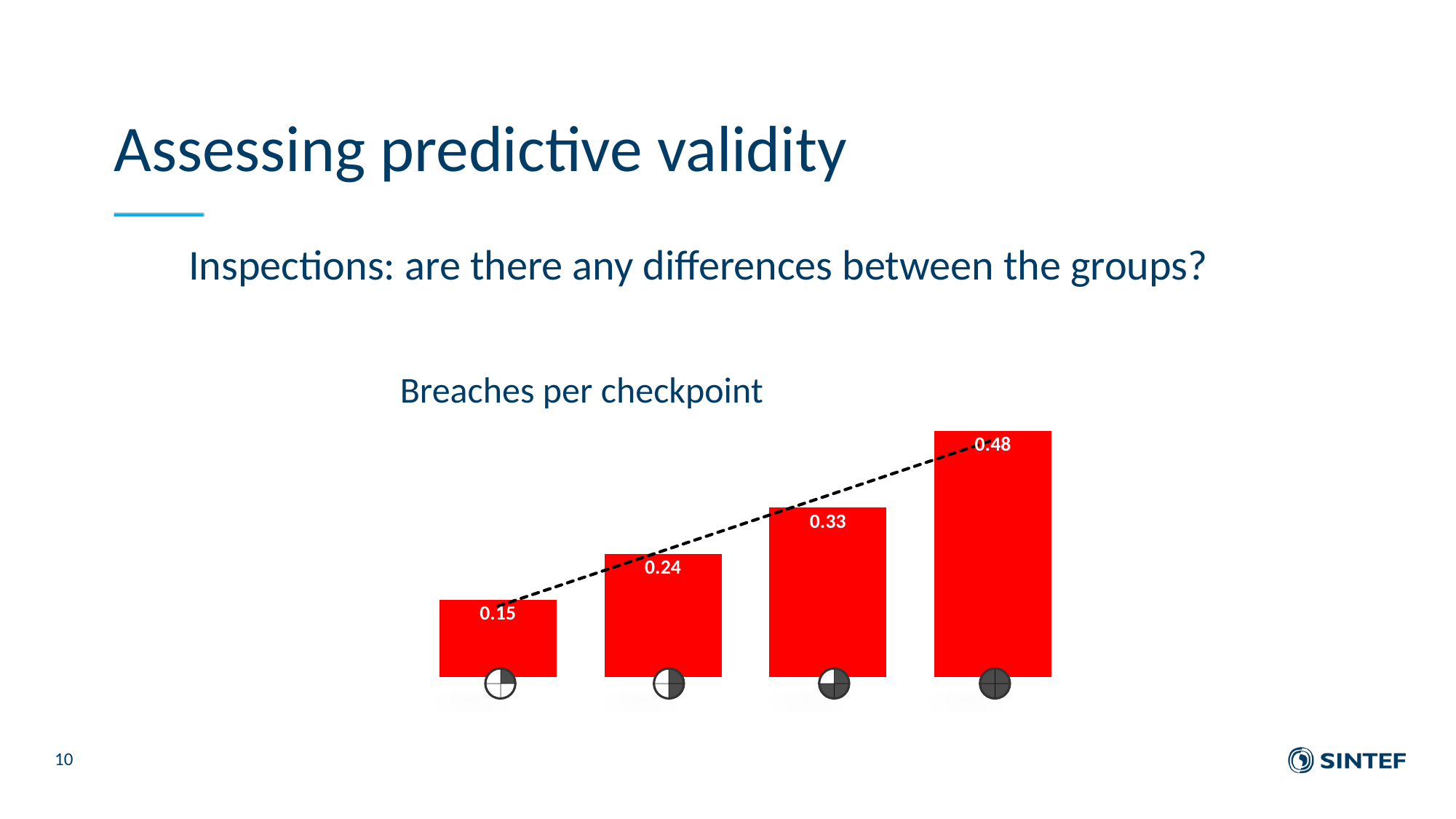
What is the value of the leftmost bar in the chart? 0.15 What is the lowest value shown in the chart? 0.15 What kind of chart is shown on the slide? bar chart What is the difference between the rightmost bar and the leftmost bar? 0.33 What is the value of the third bar from the left? 0.33 Do the bar values rise or fall from left to right? rise Which is larger, the second bar from the left or the third bar from the left? the third bar from the left What is the value of the rightmost bar in the chart? 0.48 What is the value of the second bar from the left? 0.24 What is the title of the chart? Breaches per checkpoint How many bars does the chart show? 4 What is the highest value shown in the chart? 0.48